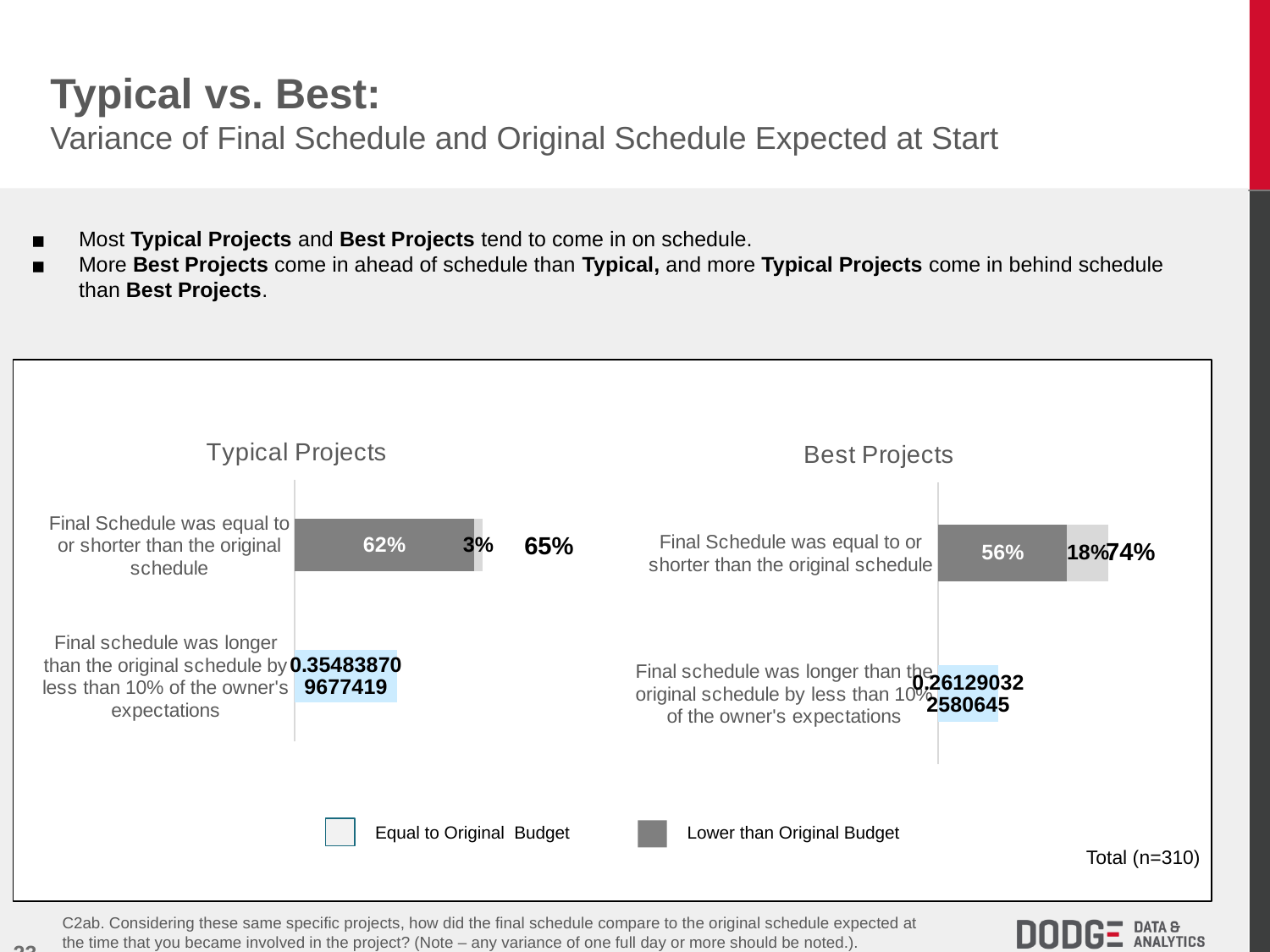
In the Best Projects chart, what is the light grey segment value for 'Final Schedule was equal to or shorter than the original schedule'? 18% What is the difference between the light grey segment values for 'equal to or shorter' in the Best Projects chart and the Typical Projects chart? 15% What type of chart is the Typical Projects chart? Bar chart In the Best Projects chart, what total is printed for the 'Final Schedule was equal to or shorter than the original schedule' bar? 74% In the Best Projects chart, what value is printed for 'Final schedule was longer than the original schedule by less than 10% of the owner's expectations'? 0.261290322580645 In the Typical Projects chart, what is the light grey segment value for 'Final Schedule was equal to or shorter than the original schedule'? 3% Which is larger: the dark grey segment for 'equal to or shorter' in the Typical Projects chart or in the Best Projects chart? Typical Projects How many entries does the legend list? 2 In the Typical Projects chart, what total is printed for the 'Final Schedule was equal to or shorter than the original schedule' bar? 65% In the Typical Projects chart, what value is printed for 'Final schedule was longer than the original schedule by less than 10% of the owner's expectations'? 0.354838709677419 In the Typical Projects chart, what is the dark grey segment value for 'Final Schedule was equal to or shorter than the original schedule'? 62% In the Best Projects chart, what is the dark grey segment value for 'Final Schedule was equal to or shorter than the original schedule'? 56%